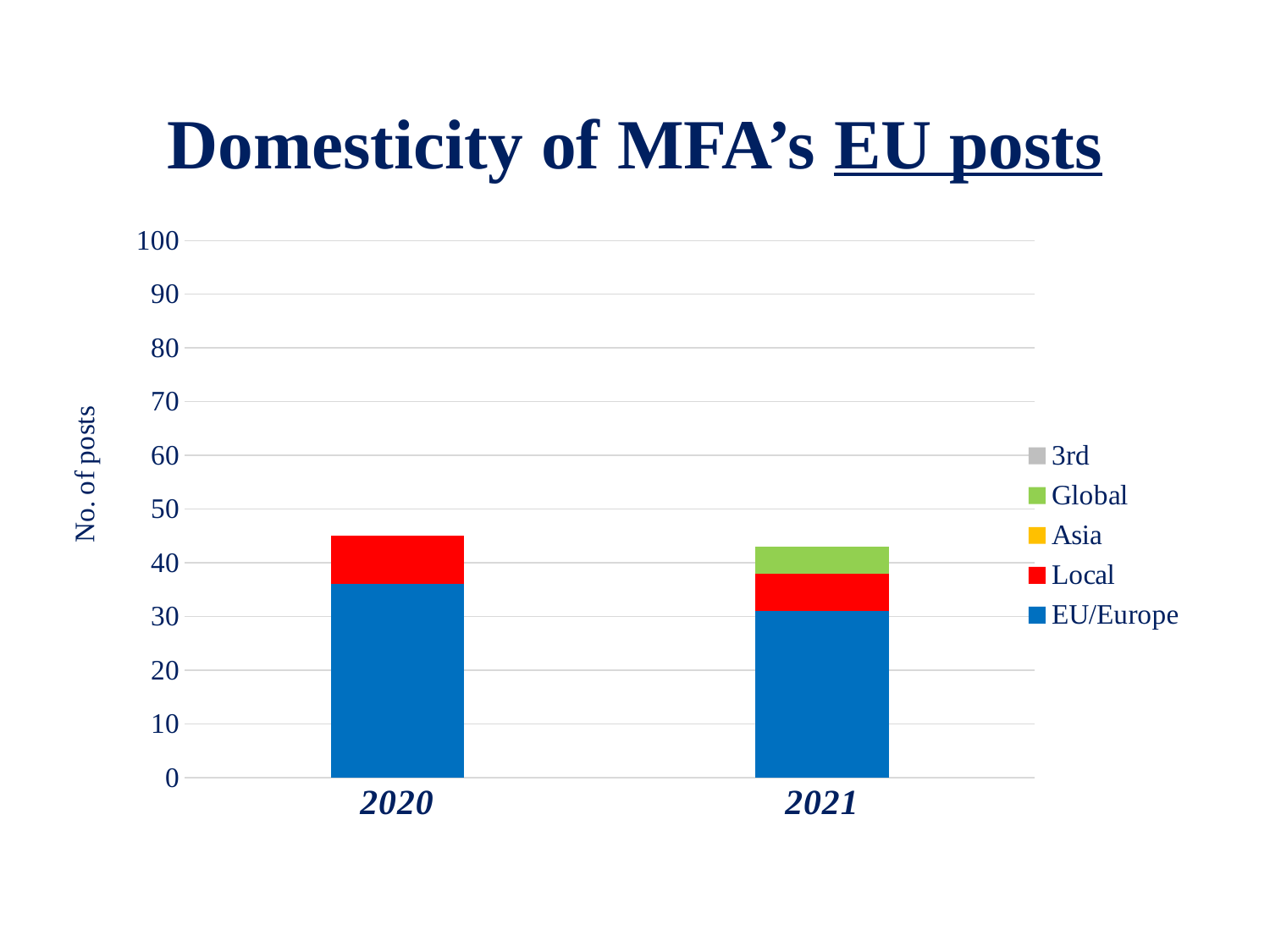
How many years (categories) are shown on the x axis? 2 What kind of chart is shown on the slide? bar chart How many series does the legend list? 5 Is the Global value for 2021 greater or less than 10? less Which year has the larger EU/Europe value, 2020 or 2021? 2020 Is the total height of the 2021 bar greater or less than 40? greater Which legend series appears in the 2021 bar but not in the 2020 bar? Global Is the EU/Europe value for 2021 greater or less than 40? less Does the EU/Europe value rise or fall from 2020 to 2021? fall What is the title of the y axis? No. of posts